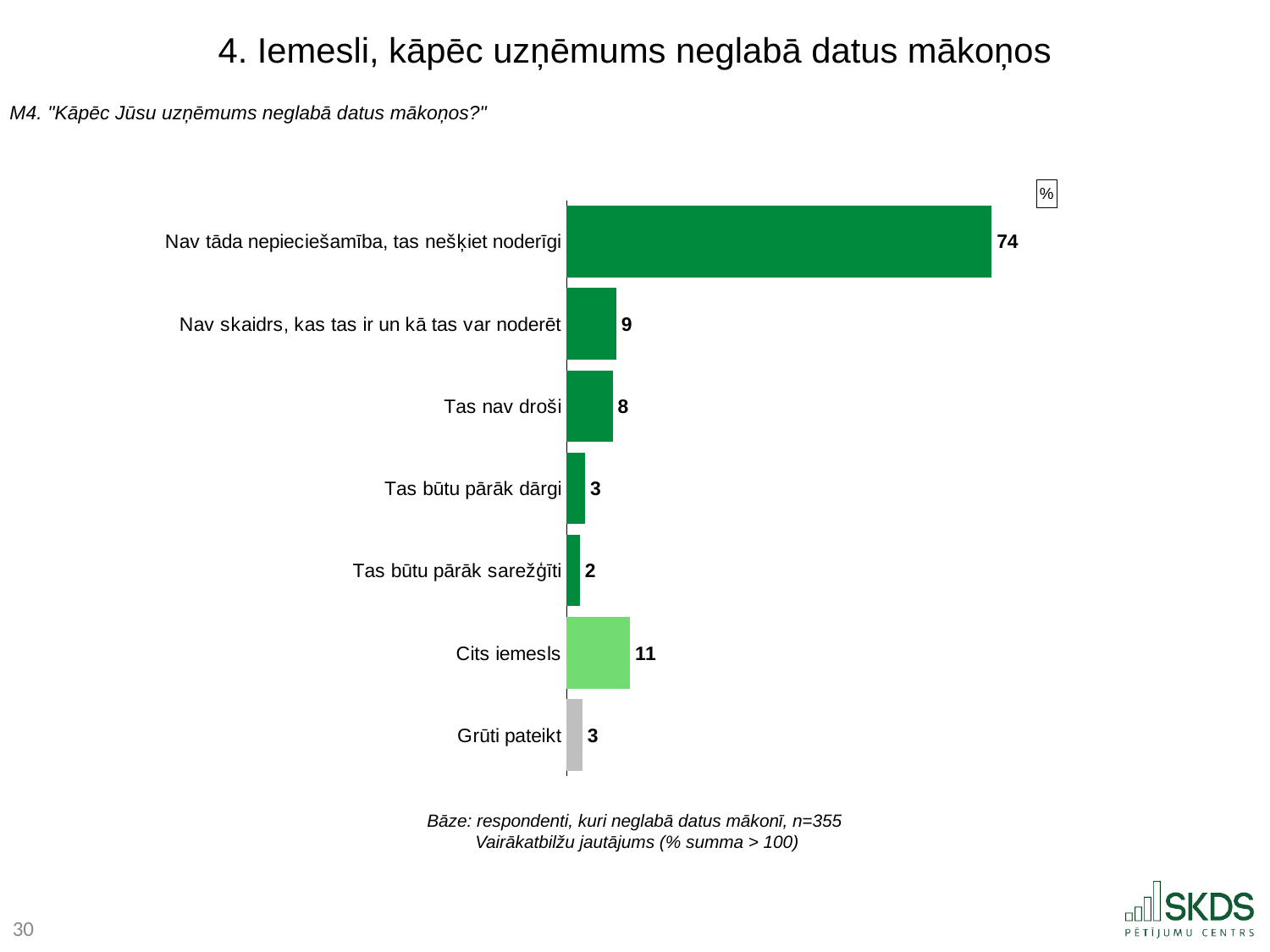
What is the base (n) stated below the chart? n=355 What is the value for "Tas nav droši"? 8 What is the value for "Tas būtu pārāk sarežģīti"? 2 What is the difference between the values for "Nav skaidrs, kas tas ir un kā tas var noderēt" and "Tas nav droši"? 1 What is the value for "Cits iemesls"? 11 What is the difference between the values for "Nav tāda nepieciešamība, tas nešķiet noderīgi" and "Cits iemesls"? 63 What kind of chart is shown on the slide? Bar chart How many categories are shown in the chart? 7 Which category has the highest value? Nav tāda nepieciešamība, tas nešķiet noderīgi What is the value for "Nav tāda nepieciešamība, tas nešķiet noderīgi"? 74 Which category has the lowest value? Tas būtu pārāk sarežģīti Which is larger, the value for "Cits iemesls" or the value for "Nav skaidrs, kas tas ir un kā tas var noderēt"? Cits iemesls